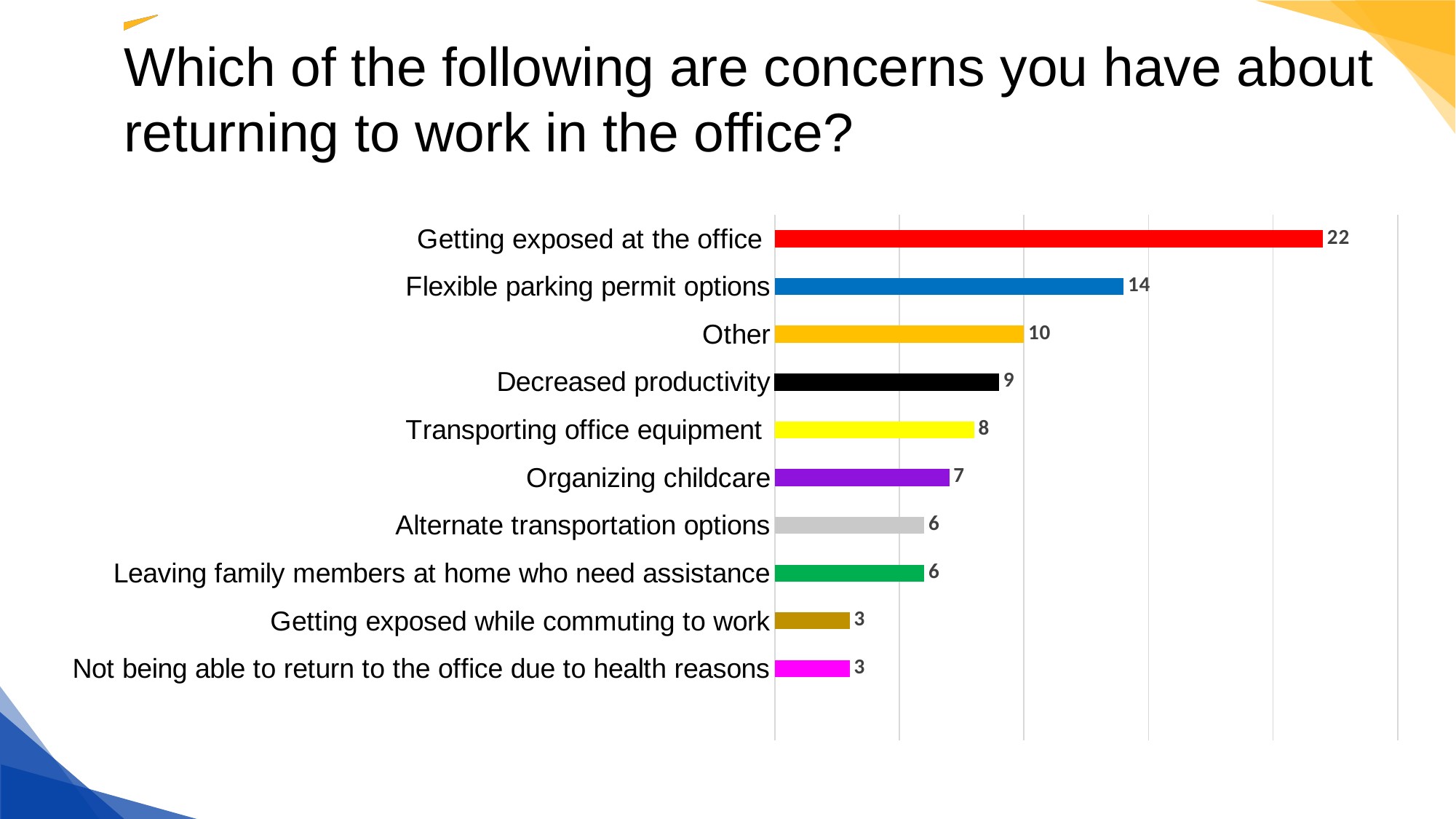
What colour is the bar for "Getting exposed at the office"? Red What kind of chart is shown on the slide? Bar chart Which concern has the highest value? Getting exposed at the office What is the value for "Organizing childcare"? 7 What is the difference between the values for "Other" and "Decreased productivity"? 1 What is the value for "Getting exposed at the office"? 22 What is the value for "Getting exposed while commuting to work"? 3 How many categories are shown in the chart? 10 What is the value for "Flexible parking permit options"? 14 What is the difference between the values for "Getting exposed at the office" and "Flexible parking permit options"? 8 Which is larger, the value for "Decreased productivity" or the value for "Organizing childcare"? Decreased productivity What is the value for "Transporting office equipment"? 8